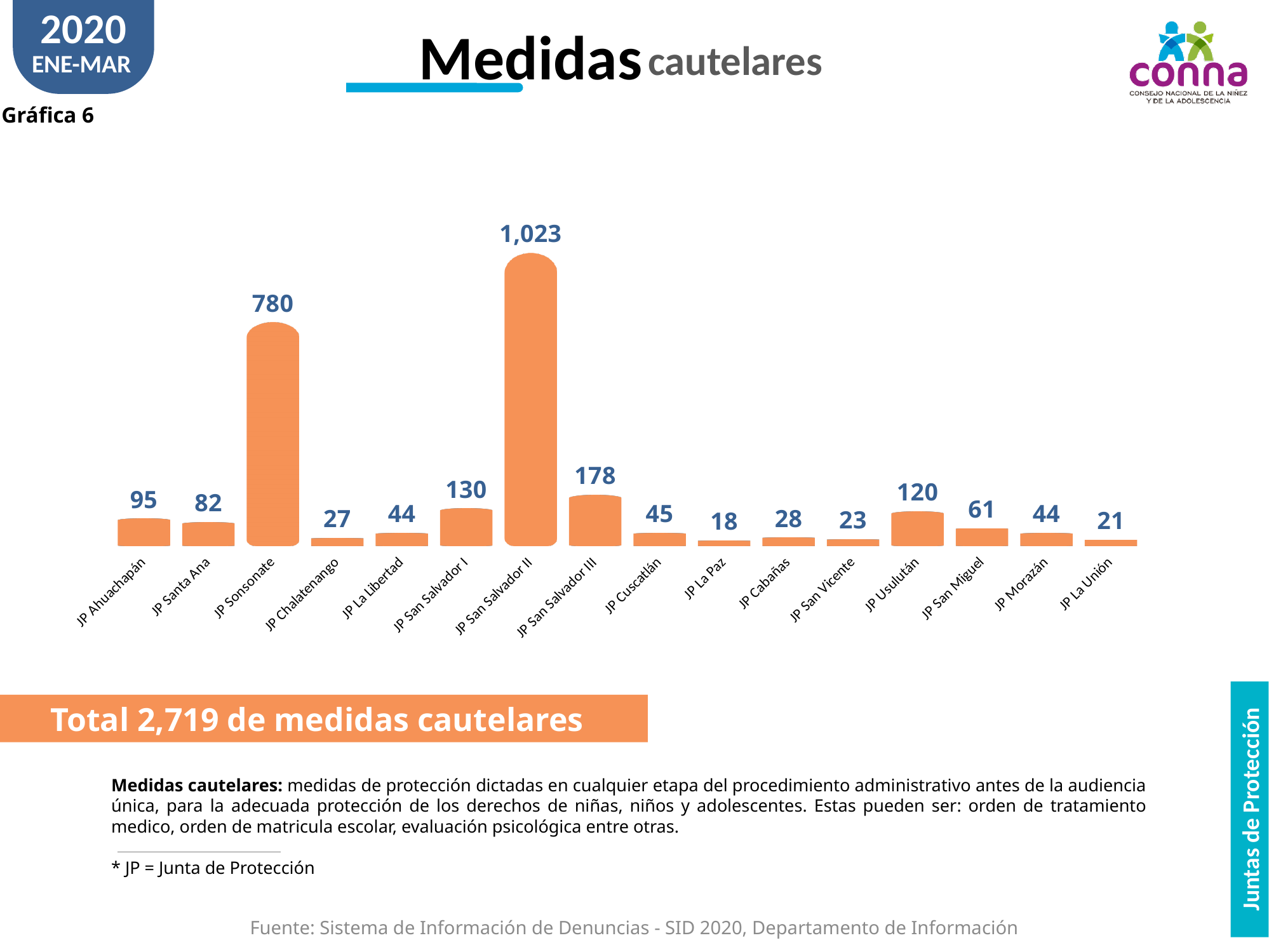
How many categories are shown on the x axis? 16 What is the value for JP Usulután? 120 What colour are the bars in the chart? orange What kind of chart is shown on the slide? bar chart What is the difference between the values for JP San Salvador III and JP San Salvador I? 48 What is the difference between the values for JP San Salvador II and JP Sonsonate? 243 What is the value for JP San Salvador II? 1,023 Which category has the lowest value? JP La Paz What is the value for JP Sonsonate? 780 Which category has the highest value? JP San Salvador II What total of medidas cautelares is stated on the slide? 2,719 Which is larger, the value for JP Ahuachapán or the value for JP Santa Ana? JP Ahuachapán